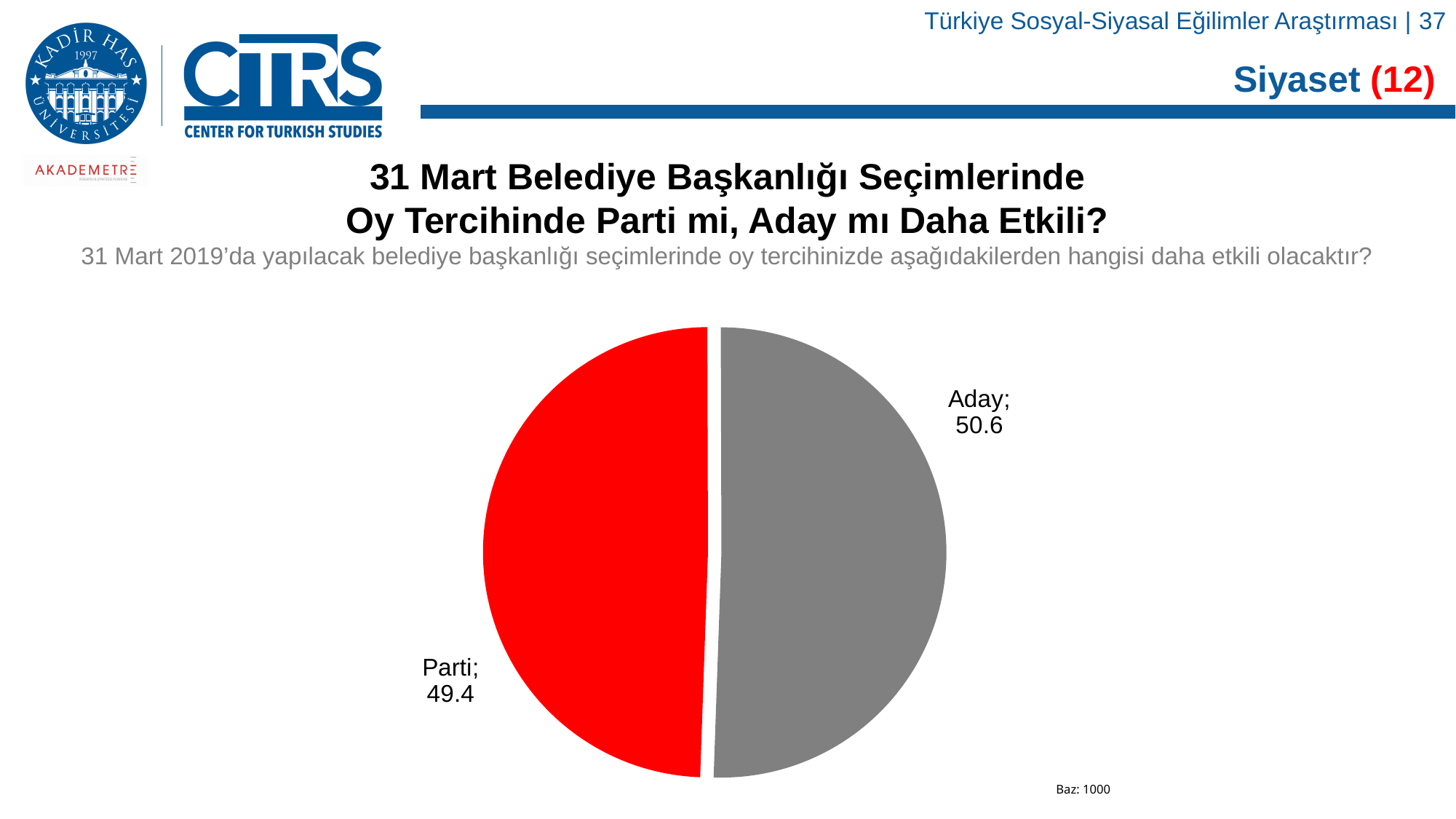
What value is shown for Aday in the pie chart? 50.6 What is the combined value of the Aday and Parti slices? 100 What value is shown for Parti in the pie chart? 49.4 What colour is the Parti slice in the pie chart? red What kind of chart is shown on the slide? pie chart What is the base (Baz) sample size noted on the slide? 1000 Which slice of the pie chart has the smaller value? Parti Is the value for Aday larger or smaller than the value for Parti? larger Which slice of the pie chart has the larger value? Aday What colour is the Aday slice in the pie chart? grey What is the difference between the values for Aday and Parti? 1.2 How many slices does the pie chart have? 2